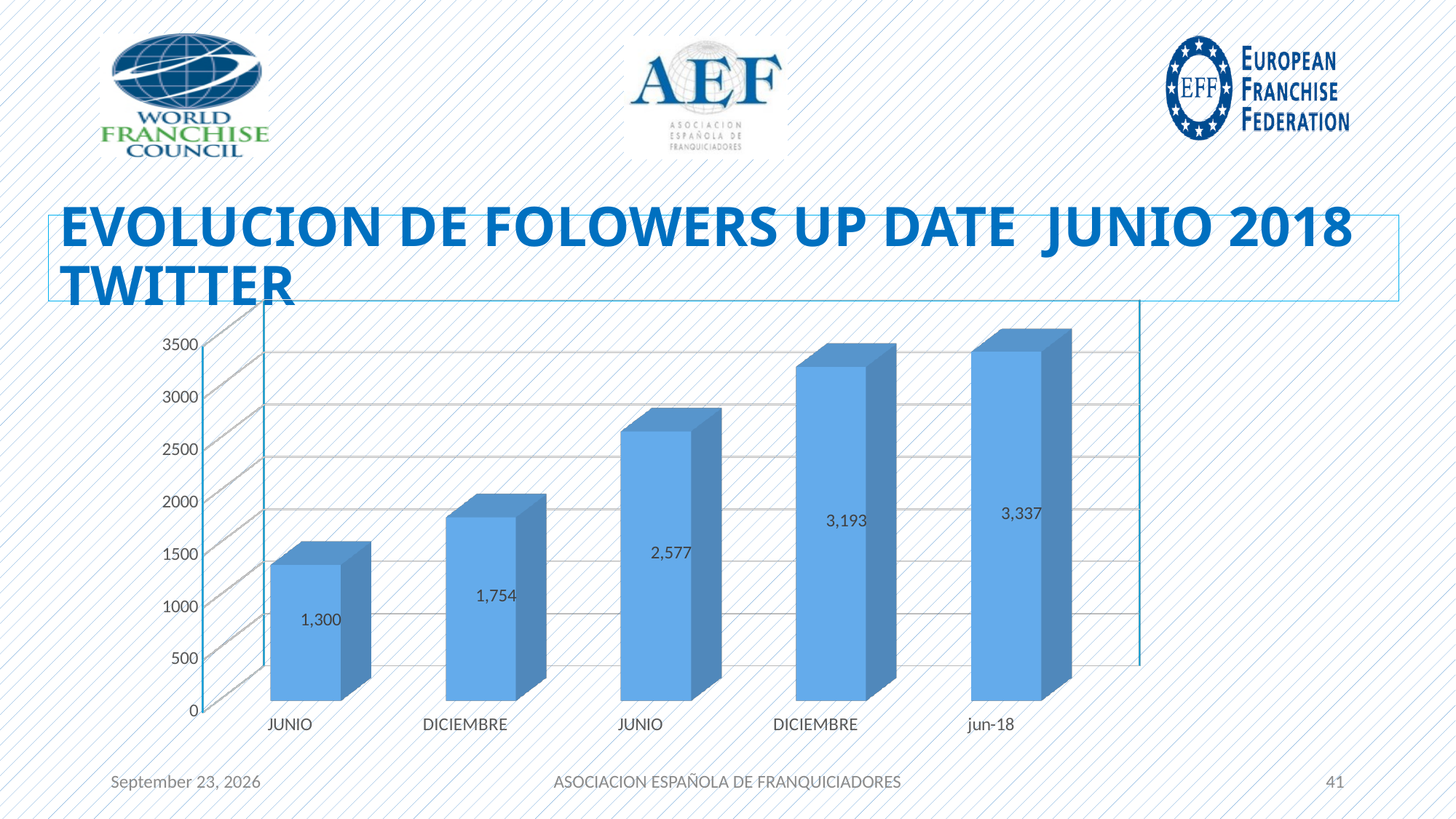
Do the values rise or fall from left to right along the x axis? Rise Which is larger, the second JUNIO bar (third from the left) or the first DICIEMBRE bar? The second JUNIO bar (2,577) What is the value for the first JUNIO bar (leftmost)? 1,300 What is the value for the second DICIEMBRE bar (fourth from the left)? 3,193 What kind of chart is shown on the slide? Bar chart What is the difference between the second DICIEMBRE bar and the second JUNIO bar? 616 What is the value for the first DICIEMBRE bar (second from the left)? 1,754 Which category has the highest value? jun-18 What is the value for jun-18? 3,337 Which bar has the lowest value? The first JUNIO bar (leftmost), 1,300 What is the difference between the jun-18 value and the first JUNIO value? 2,037 How many bars are plotted in the chart? 5